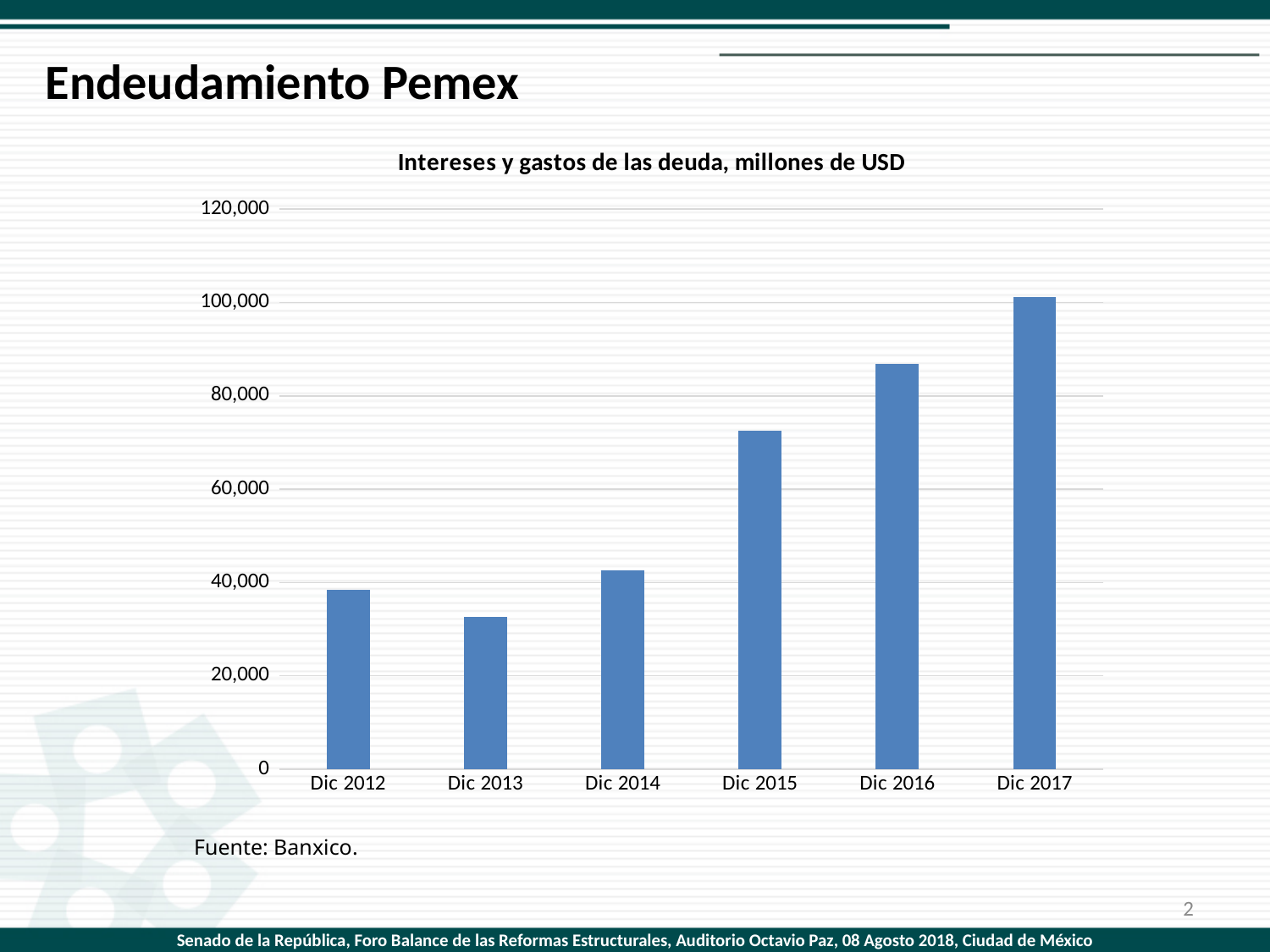
Is the value for Dic 2017 greater or less than 80,000? greater What kind of chart is shown on the slide? bar chart How many categories (dates) are shown on the x axis of the chart? 6 Which date has the highest value in the chart? Dic 2017 Is the value for Dic 2015 greater or less than 80,000? less Is the value for Dic 2016 greater or less than 80,000? greater Do the values generally rise or fall from Dic 2013 to Dic 2017? rise What is the title of the chart? Intereses y gastos de las deuda, millones de USD Which date has the lowest value in the chart? Dic 2013 Which is larger, the value for Dic 2012 or the value for Dic 2013? Dic 2012